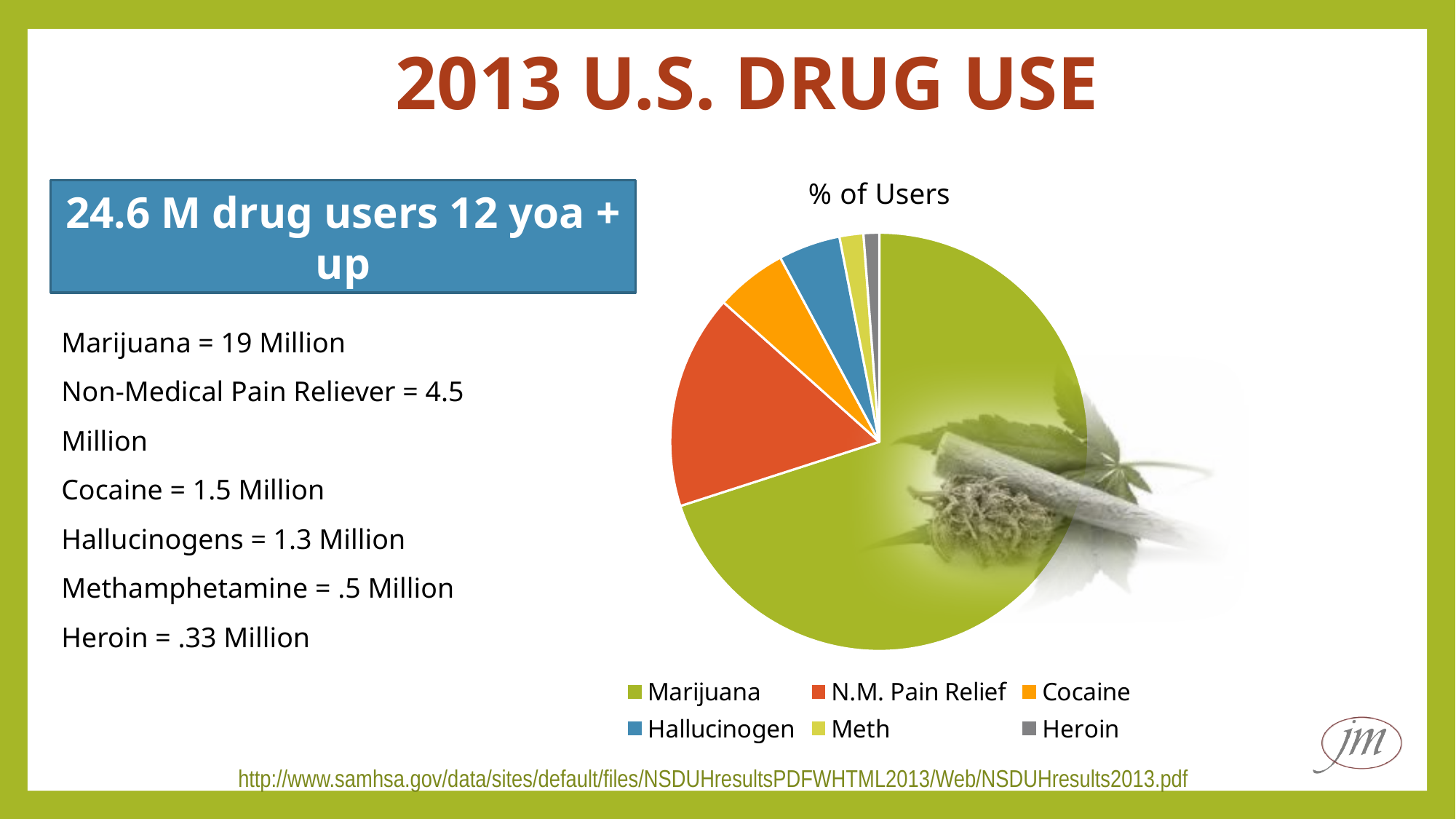
Which category has the largest slice of the pie chart? Marijuana Is the Marijuana slice greater or less than half of the pie chart? greater Which slice is larger in the pie chart, Marijuana or N.M. Pain Relief? Marijuana How many entries does the pie chart's legend list? 6 Which slice is larger in the pie chart, N.M. Pain Relief or Cocaine? N.M. Pain Relief Which category has the smallest slice of the pie chart? Heroin Which slice is larger in the pie chart, Hallucinogen or Heroin? Hallucinogen What colour is the Marijuana slice in the pie chart? green What kind of chart is shown on the slide? pie chart How many slices does the pie chart have? 6 What is the title of the pie chart? % of Users